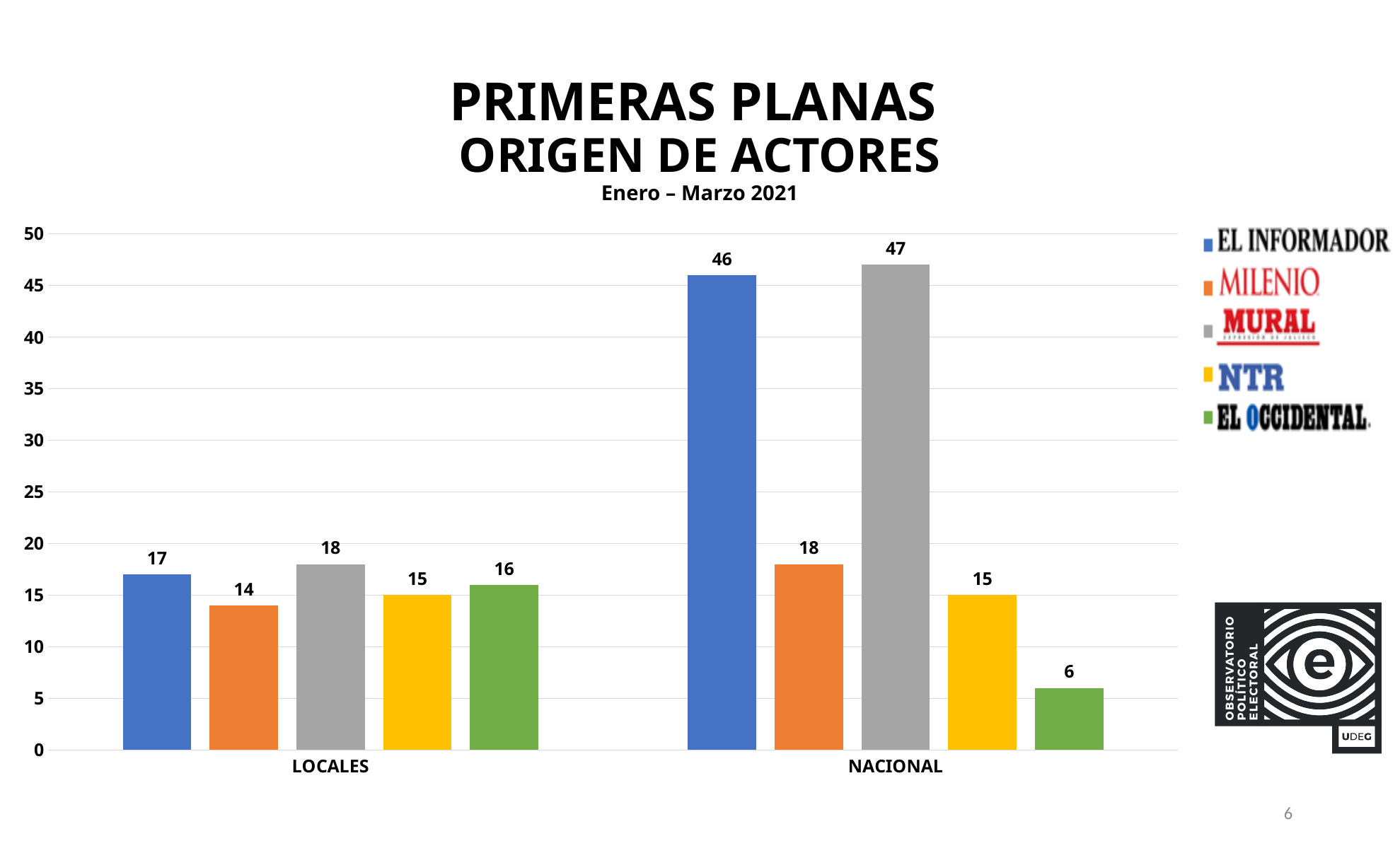
Is the value for MURAL in the NACIONAL category greater or less than 45? greater Which newspaper has the highest value in the NACIONAL category? MURAL Which newspaper has the lowest value in the LOCALES category? MILENIO What kind of chart is shown on the slide? Bar chart What is the value for EL OCCIDENTAL in the NACIONAL category? 6 What is the value for EL INFORMADOR in the LOCALES category? 17 What is the value for MURAL in the NACIONAL category? 47 Which is larger for MILENIO: the LOCALES value or the NACIONAL value? NACIONAL How many categories are shown on the x axis? 2 What is the difference between the NACIONAL and LOCALES values for EL INFORMADOR? 29 What period does the chart subtitle indicate? Enero – Marzo 2021 How many series does the legend list? 5